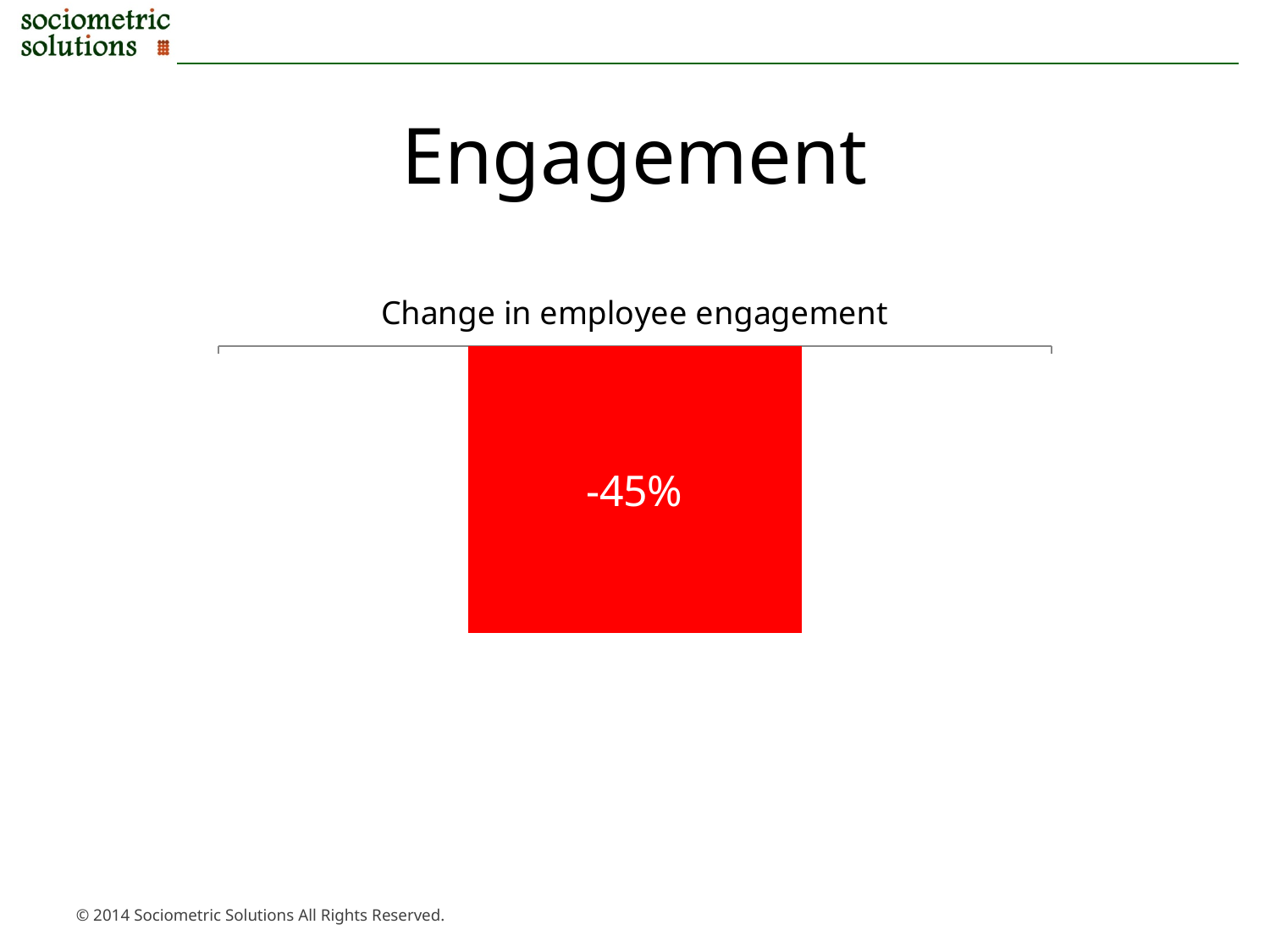
How many bars are plotted in the 'Change in employee engagement' chart? 1 What colour is the bar in the 'Change in employee engagement' chart? red What value is shown on the bar in the 'Change in employee engagement' chart? -45% What kind of chart is shown on the slide? bar chart What is the title of the chart on the slide? Change in employee engagement Is the value shown in the 'Change in employee engagement' chart positive or negative? negative